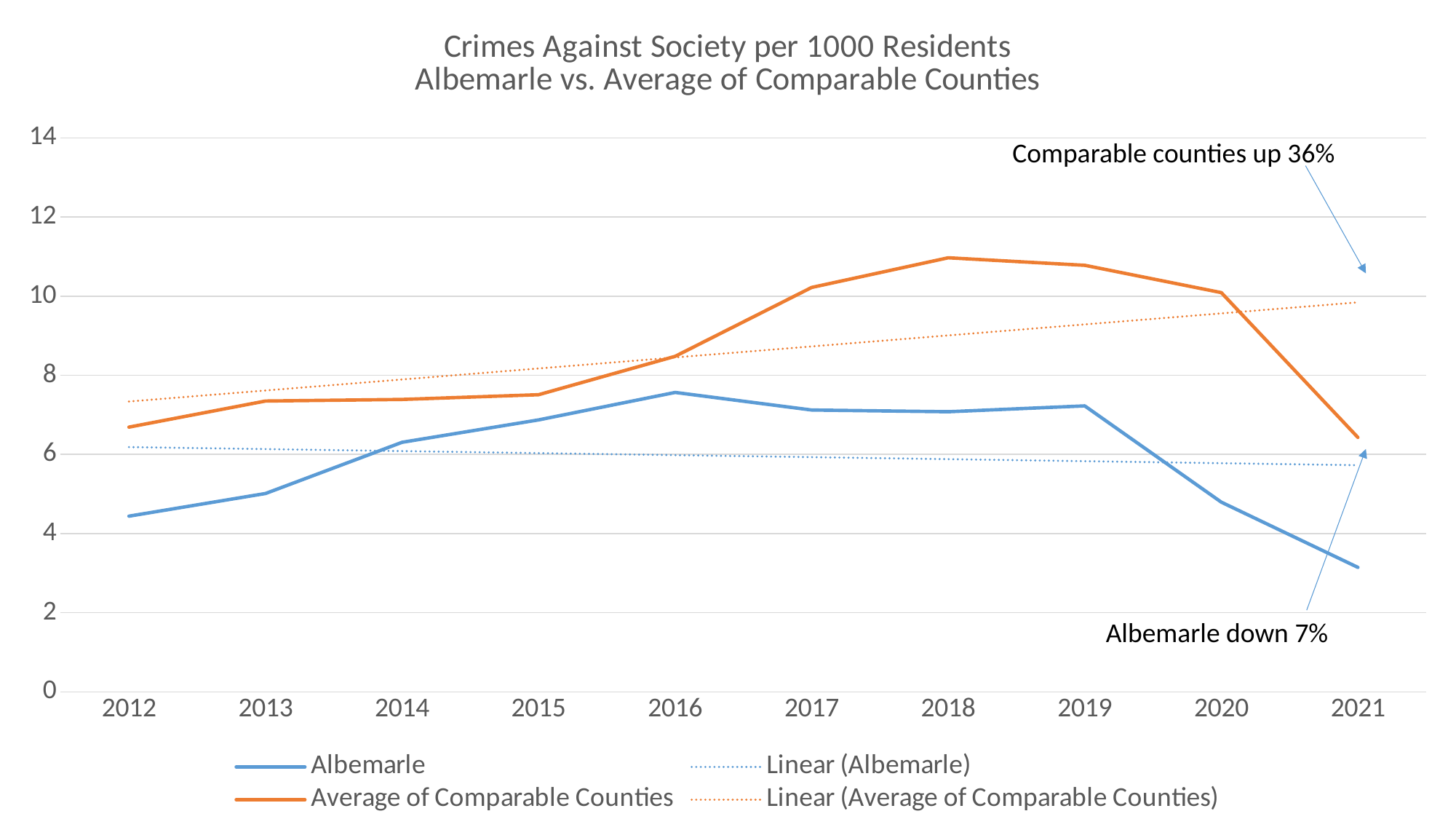
Is the Albemarle value for 2012 greater or less than 6? less How many years are plotted along the x axis? 10 How many entries does the legend list? 4 In which year does the Average of Comparable Counties line reach its highest value? 2018 According to the annotation on the chart, by what percentage are comparable counties up? 36% In 2021, which is larger: Albemarle or Average of Comparable Counties? Average of Comparable Counties What kind of chart is shown on the slide? Line chart In which year does the Albemarle line reach its lowest value? 2021 In which year does the Albemarle line reach its highest value? 2016 Does the Albemarle line rise or fall from 2019 to 2021? Fall Is the Albemarle value for 2021 greater or less than 4? less Is the Average of Comparable Counties value for 2018 greater or less than 10? greater